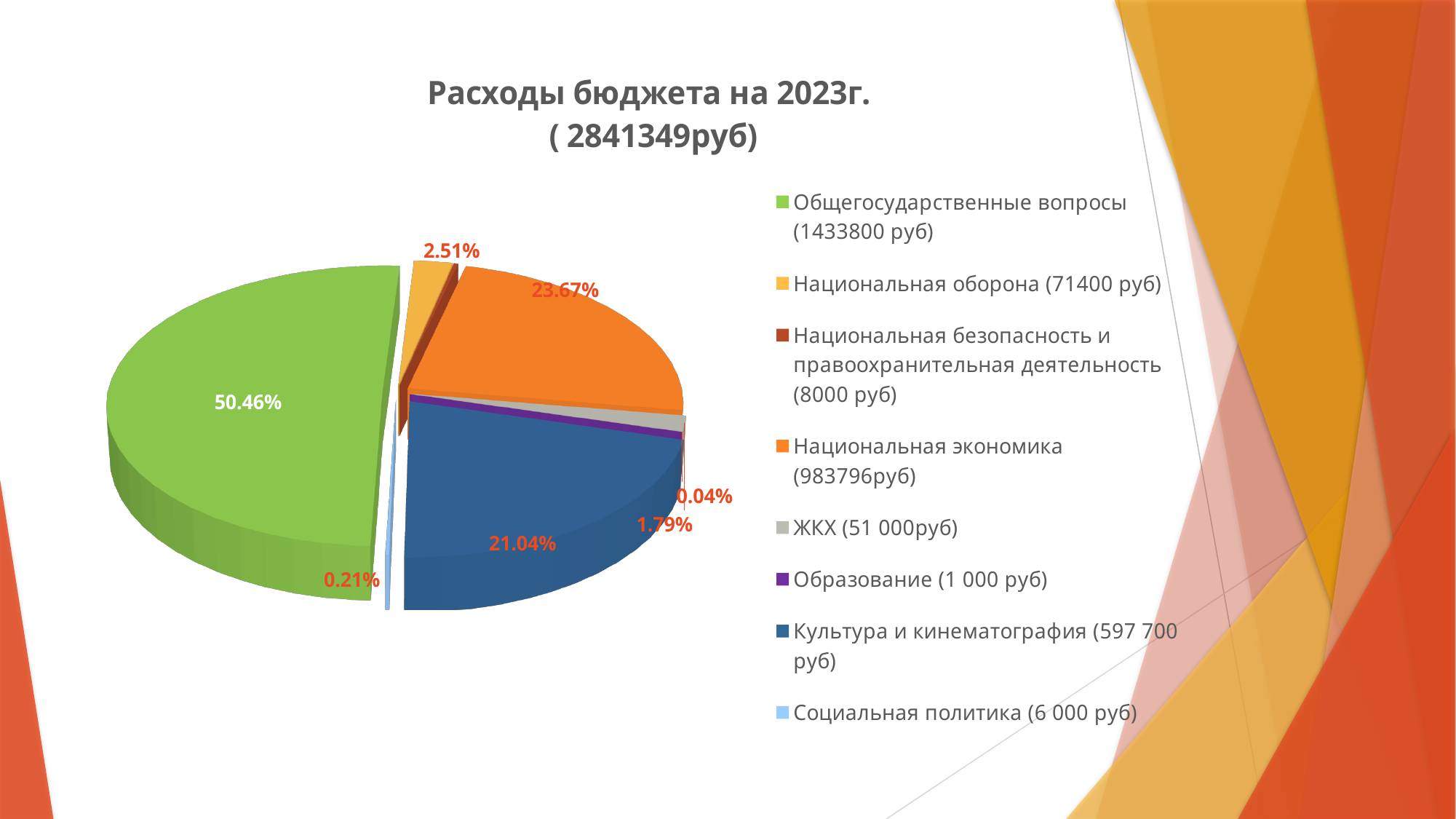
Which has a larger share: Национальная оборона or Социальная политика? Национальная оборона What percentage share is shown for ЖКХ? 1.79% What percentage share is shown for Культура и кинематография? 21.04% What is the title of the chart? Расходы бюджета на 2023г. ( 2841349руб) What is the difference in percentage points between the shares of Национальная экономика and Культура и кинематография? 2.63 Which category has the smallest labelled share of the pie? Образование What kind of chart is shown on the slide? Pie chart According to the legend, what amount in rubles is given for Национальная оборона? 71400 руб What percentage share is shown for Национальная экономика? 23.67% How many categories does the legend list? 8 What percentage share is shown for Общегосударственные вопросы? 50.46% Which category has the largest share of the pie? Общегосударственные вопросы